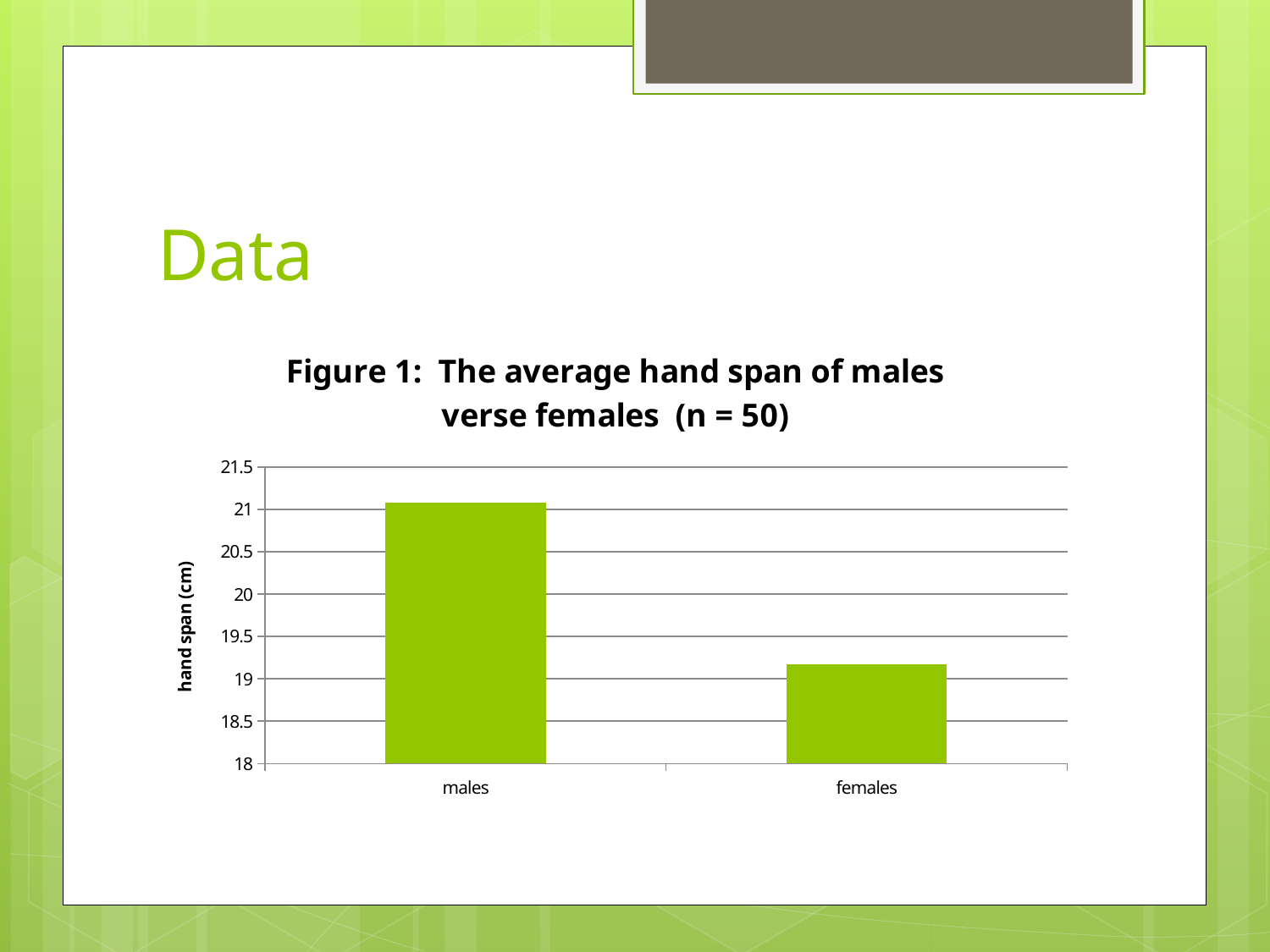
Is the average hand span for males greater or less than 20? greater Which category has the lowest average hand span? females Is the average hand span for females greater or less than 19? greater Do the values rise or fall from males to females along the x axis? fall Which is larger, the average hand span for males or for females? males What is the title of the chart? Figure 1: The average hand span of males verse females (n = 50) Is the average hand span for females greater or less than 19.5? less What is the label of the vertical axis? hand span (cm) How many categories are shown on the x axis? 2 Which category has the highest average hand span? males What kind of chart is shown on the slide? bar chart